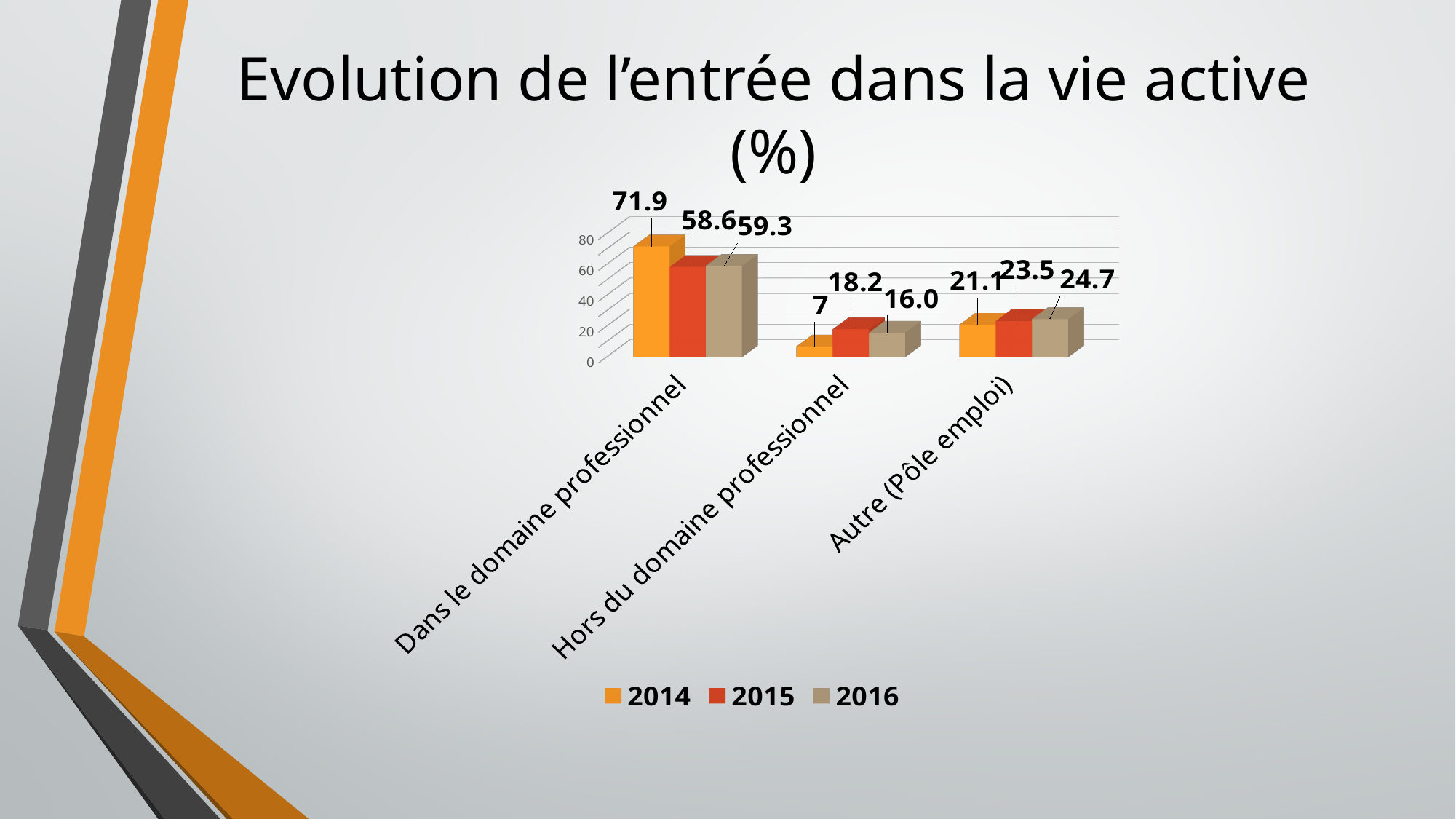
What kind of chart is shown on the slide? Bar chart How many series does the legend list? 3 What is the difference between the 2014 and 2015 values for 'Dans le domaine professionnel'? 13.3 What is the value for 2014 in the 'Dans le domaine professionnel' category? 71.9 Which category has the lowest value for 2016? Hors du domaine professionnel What is the value for 2015 in the 'Autre (Pôle emploi)' category? 23.5 How many categories are shown on the x axis? 3 Do the values for 'Autre (Pôle emploi)' rise or fall from 2014 to 2016? Rise What is the value for 2014 in the 'Hors du domaine professionnel' category? 7 Which is larger for 'Autre (Pôle emploi)': the 2014 value or the 2016 value? 2016 Which category has the highest value for 2014? Dans le domaine professionnel What is the value for 2016 in the 'Hors du domaine professionnel' category? 16.0